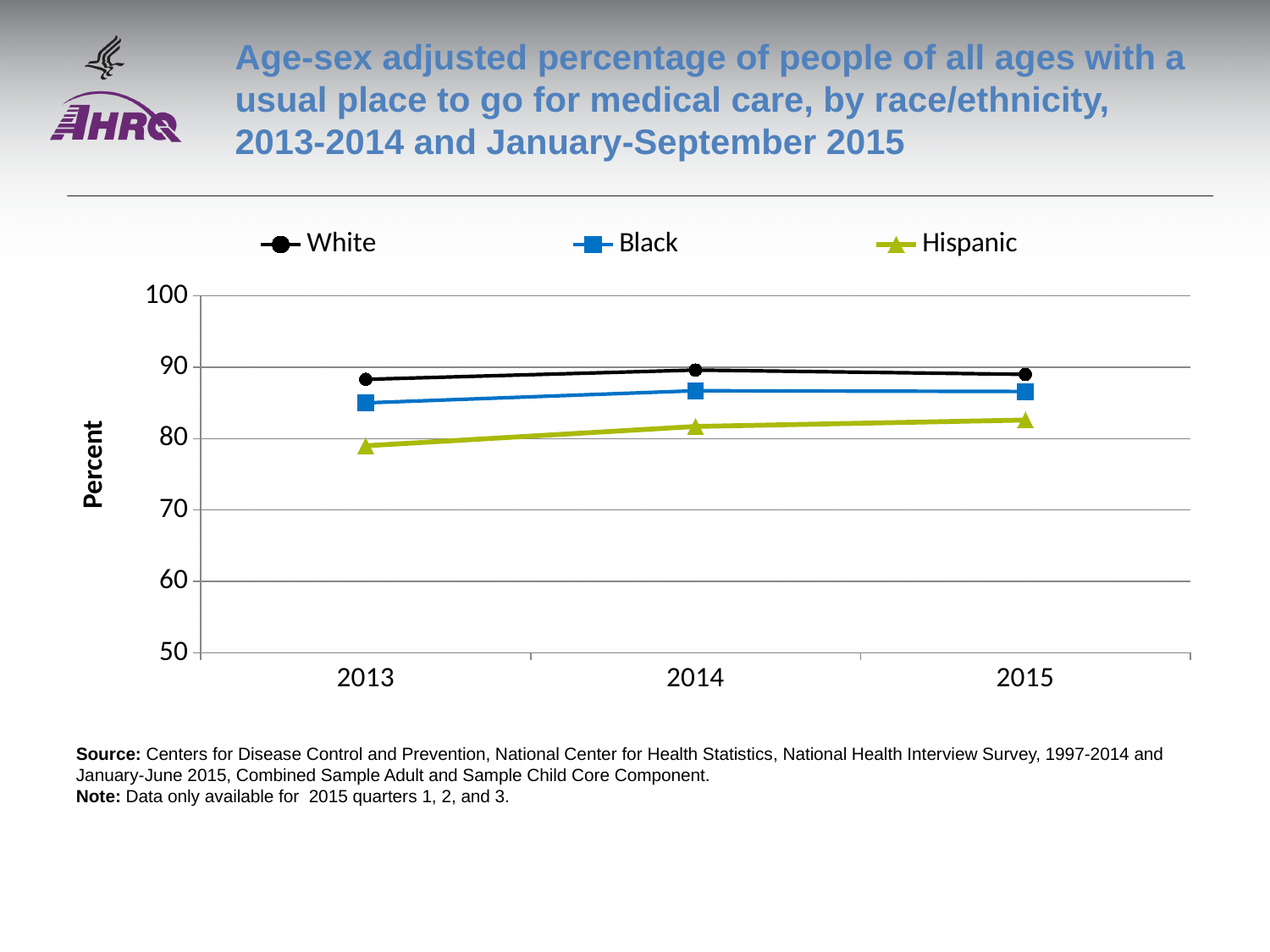
Does the Hispanic line rise or fall from 2013 to 2015? rise How many series does the legend list? 3 How many years are shown on the x axis? 3 What kind of chart is shown on the slide? line chart Which is larger in 2015, the value for White or the value for Hispanic? White Is the value for Hispanic in 2013 greater or less than 80? less Which race/ethnicity group has the highest percentage in 2013? White Which race/ethnicity group has the lowest percentage in 2013? Hispanic Which series is drawn with triangle markers? Hispanic Is the value for White in 2014 greater or less than 80? greater Is the value for Black in 2015 greater or less than 90? less What is the label on the y axis? Percent